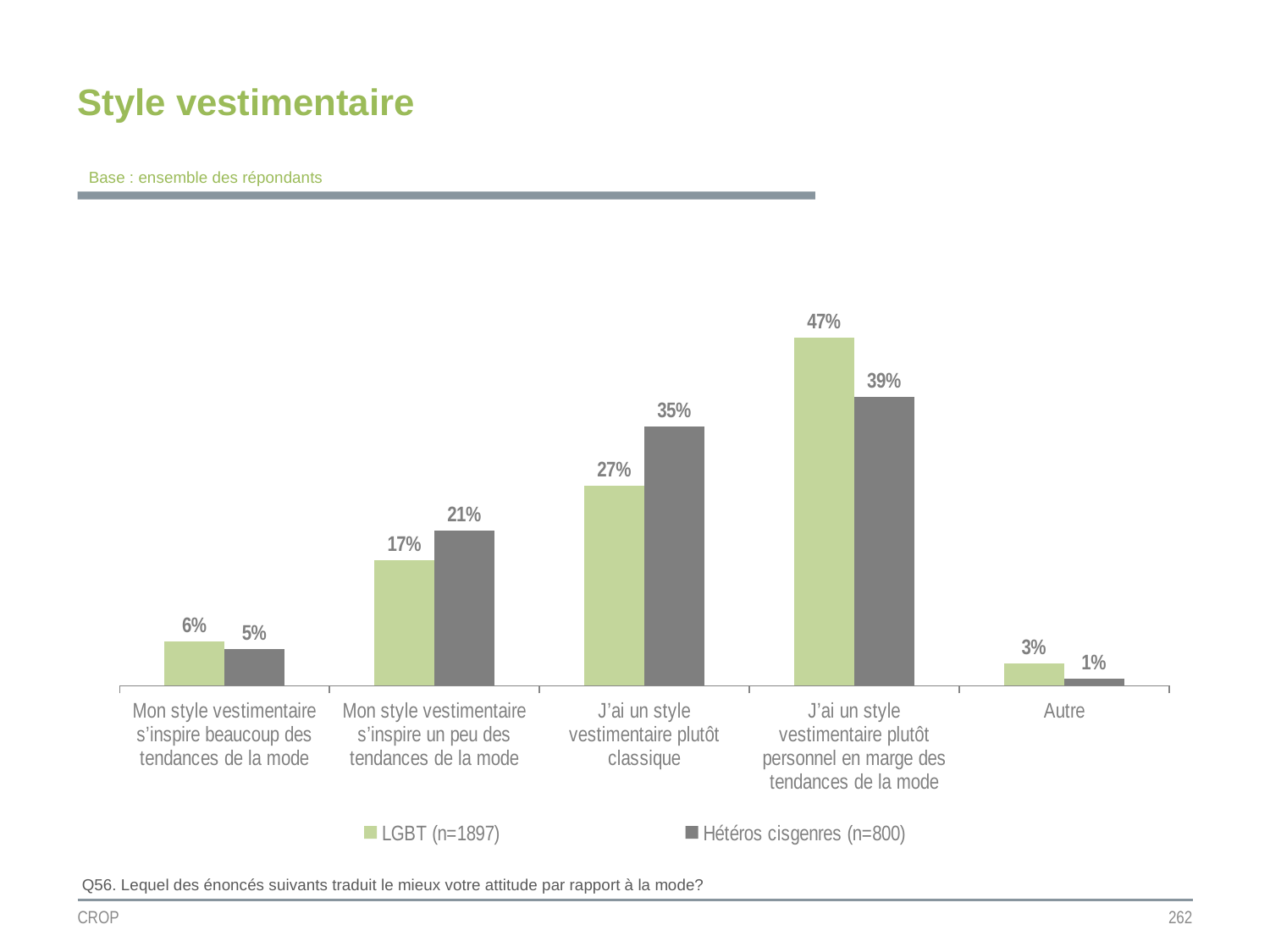
Which category has the lowest value for Hétéros cisgenres (n=800)? Autre Which category has the highest value for LGBT (n=1897)? J'ai un style vestimentaire plutôt personnel en marge des tendances de la mode How many series does the legend list? 2 Which series has the larger value for "Mon style vestimentaire s'inspire beaucoup des tendances de la mode"? LGBT (n=1897) What is the difference between LGBT (n=1897) and Hétéros cisgenres (n=800) for "J'ai un style vestimentaire plutôt personnel en marge des tendances de la mode"? 8% What is the value for LGBT (n=1897) for "Autre"? 3% What is the difference between Hétéros cisgenres (n=800) and LGBT (n=1897) for "J'ai un style vestimentaire plutôt classique"? 8% What is the value for Hétéros cisgenres (n=800) for "Mon style vestimentaire s'inspire un peu des tendances de la mode"? 21% How many categories are shown on the x axis? 5 What kind of chart is shown on the slide? Bar chart What is the value for LGBT (n=1897) for "J'ai un style vestimentaire plutôt classique"? 27% What is the title of the slide? Style vestimentaire